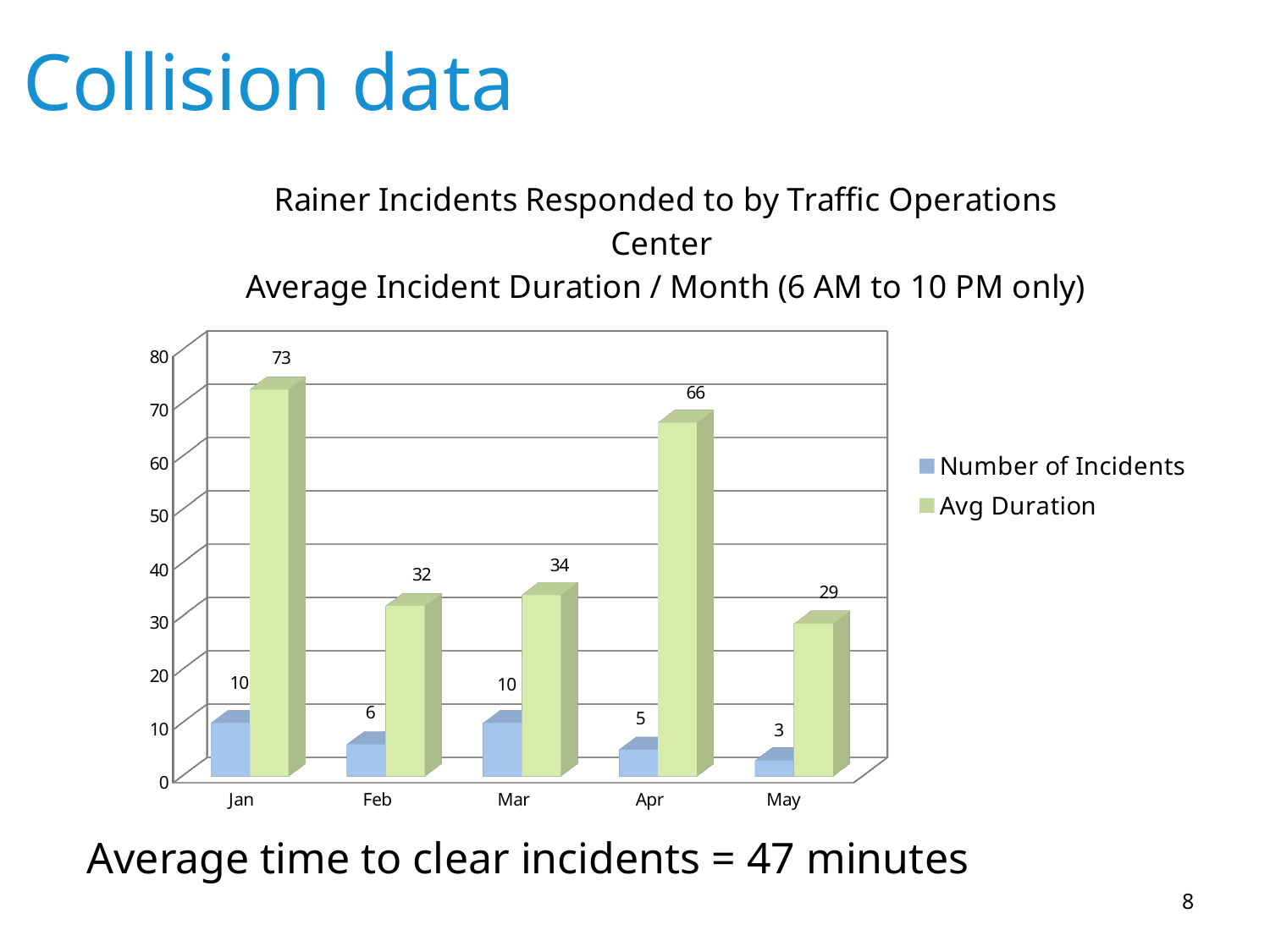
What is the Number of Incidents value for Apr? 5 What is the Avg Duration value for Jan? 73 What is the difference between the Number of Incidents for Jan and Feb? 4 Which colour represents the Avg Duration series in the legend? Green Which month has the highest Avg Duration? Jan How many series does the legend list? 2 How many months are shown on the x axis? 5 Does the Number of Incidents rise or fall from Mar to May? Fall Which is larger, the Avg Duration for Feb or for Mar? Mar What kind of chart is shown on the slide? Bar chart Which month has the lowest Number of Incidents? May What is the difference between the Avg Duration for Jan and Apr? 7